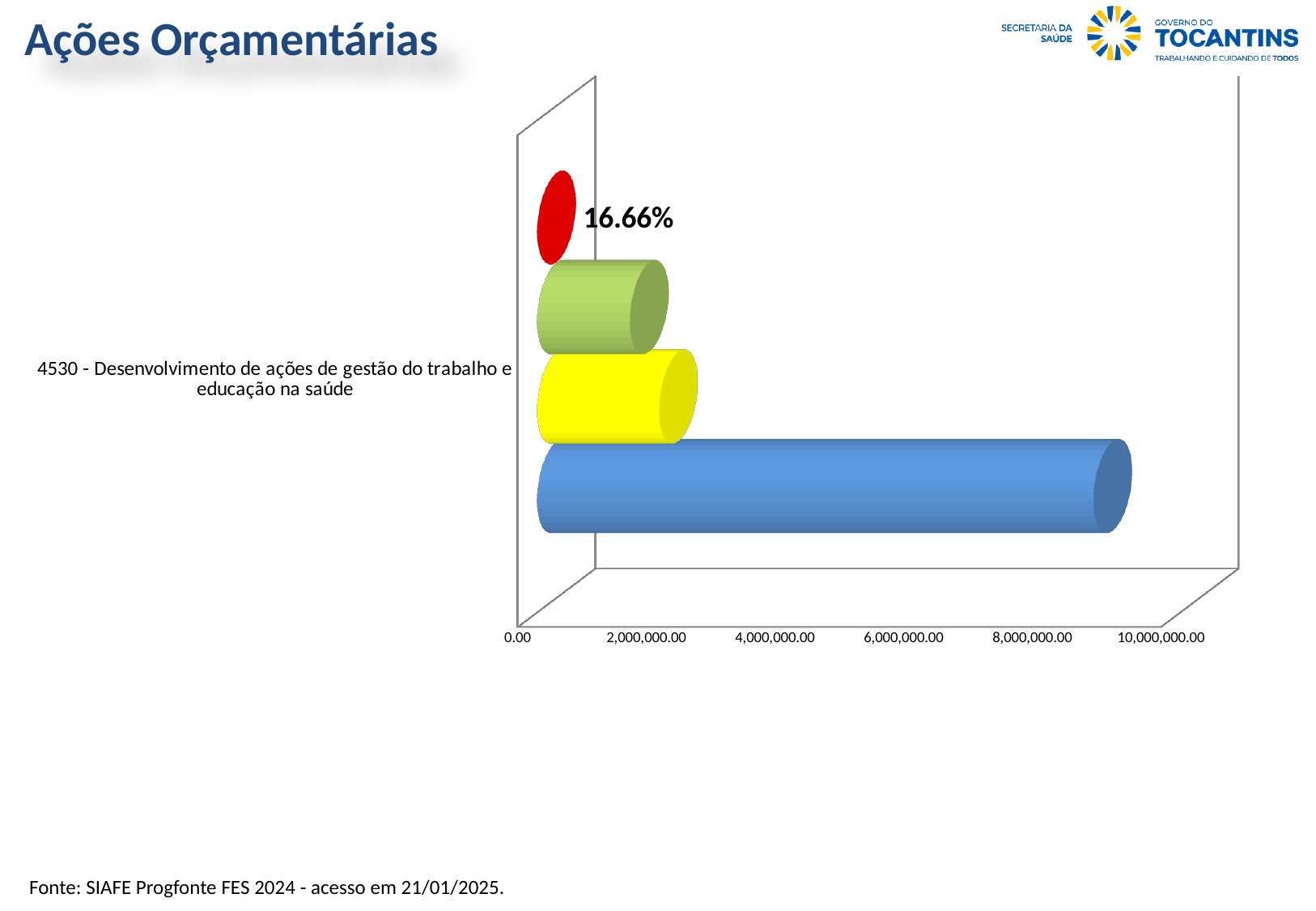
Is the value of the blue bar greater or less than 8,000,000.00? greater Which coloured bar is the shortest in the chart? red What is the highest value shown on the horizontal axis of the chart? 10,000,000.00 Which is larger, the blue bar or the yellow bar? blue bar Is the value of the yellow bar greater or less than 4,000,000.00? less What is the category label shown on the chart? 4530 - Desenvolvimento de ações de gestão do trabalho e educação na saúde What data label is printed next to the red bar? 16.66% Which is larger, the yellow bar or the green bar? yellow bar Which coloured bar is the longest in the chart? blue How many categories are shown on the vertical axis of the chart? 1 What kind of chart is shown on the slide? bar chart Is the value of the green bar greater or less than 4,000,000.00? less